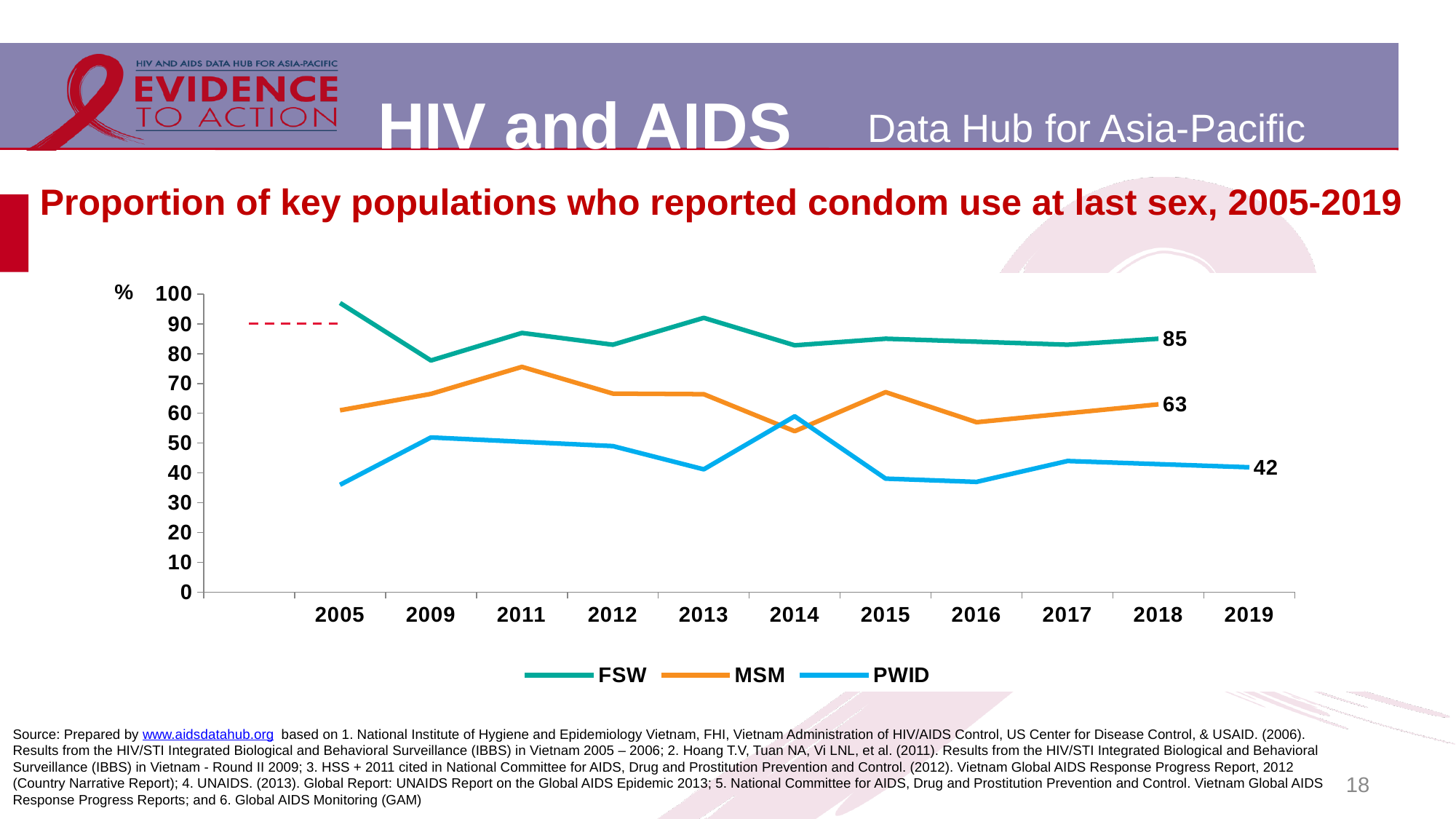
Is the value for PWID in 2005 greater or less than 40? less What is the final labelled value for the PWID line? 42 How many series does the legend list? 3 What is the final labelled value for the FSW line? 85 How many years are shown on the x axis? 11 Which key population has the highest final labelled value? FSW Is the value for FSW in 2005 greater or less than 90? greater What is the final labelled value for the MSM line? 63 What is the difference between the final labelled values of the FSW and PWID lines? 43 What is the difference between the final labelled values of the MSM and PWID lines? 21 Which is larger in 2005, the value for FSW or the value for MSM? FSW What type of chart is shown on the slide? line chart